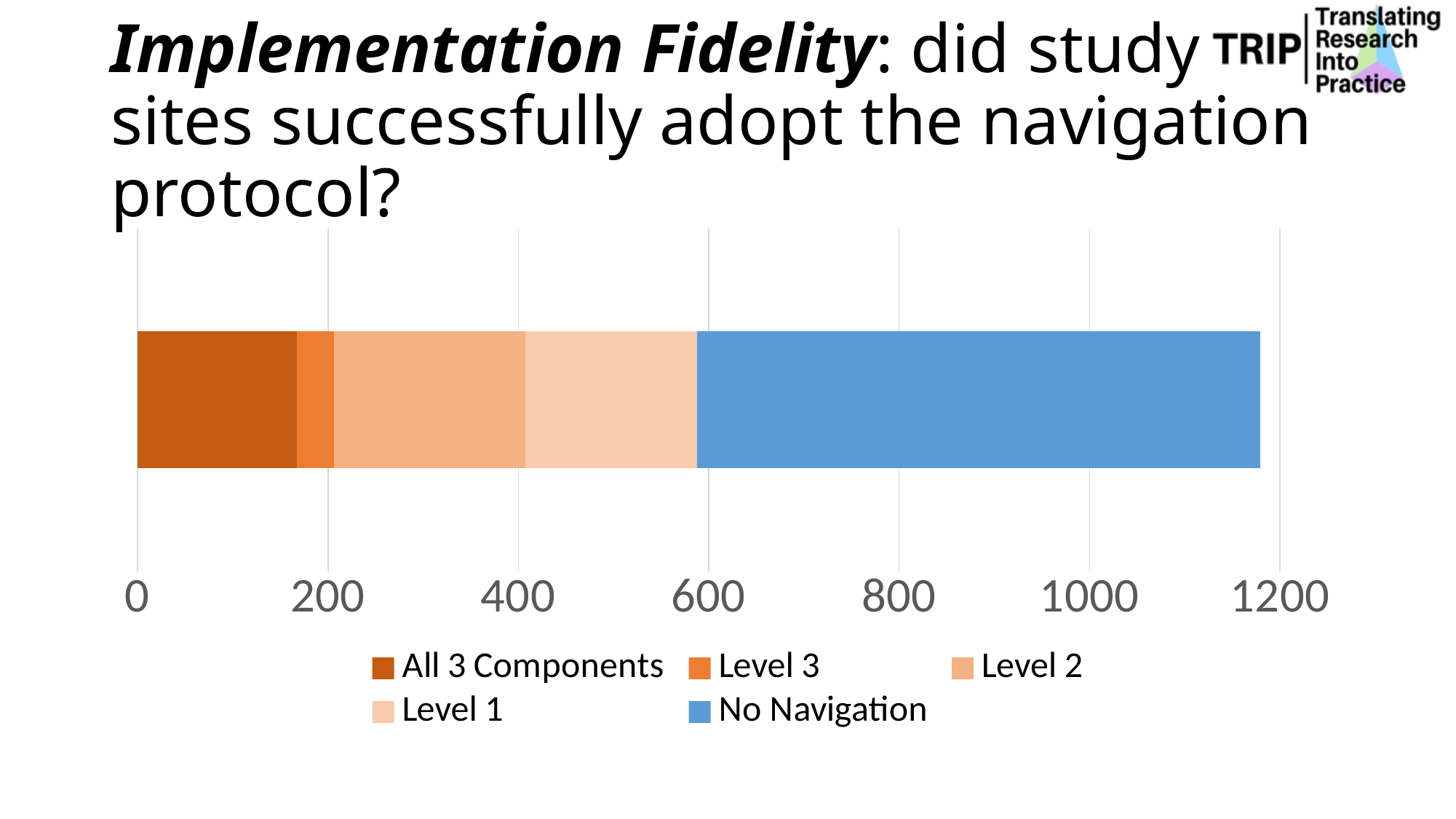
Which segment is larger, No Navigation or All 3 Components? No Navigation What kind of chart is shown on the slide? Stacked bar chart Which series has the largest segment in the bar? No Navigation How many series does the legend list? 5 Is the value for Level 3 greater or less than 100? less Is the total length of the stacked bar greater or less than 1000? greater Which series is shown in blue in the legend? No Navigation Is the value for No Navigation greater or less than 400? greater Which segment is larger, Level 2 or Level 3? Level 2 How many bars are plotted in the chart? 1 Which series has the smallest segment in the bar? Level 3